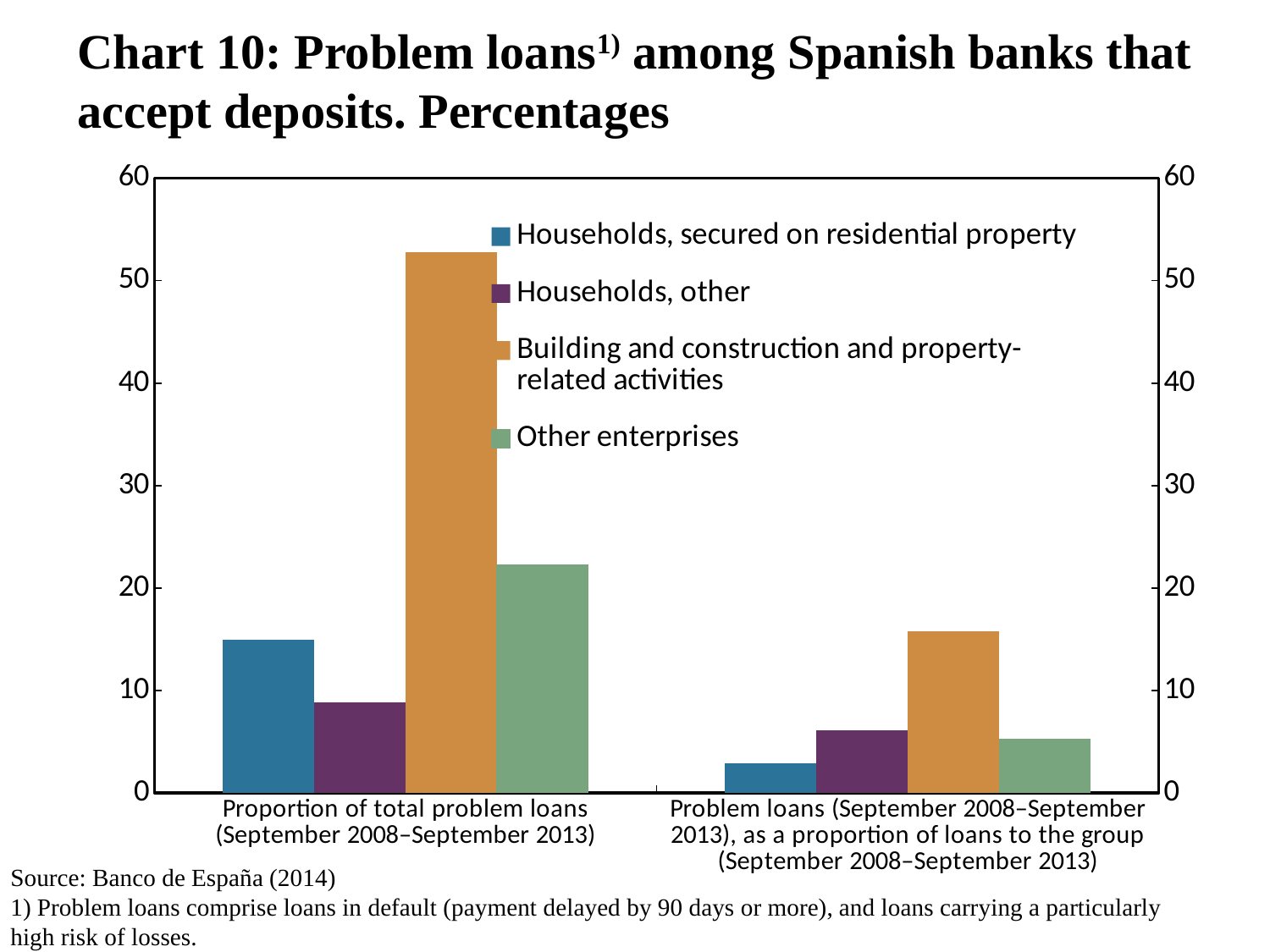
How many series does the legend list? 4 Is the value for 'Building and construction and property-related activities' in 'Proportion of total problem loans (September 2008–September 2013)' greater or less than 50? greater In 'Proportion of total problem loans (September 2008–September 2013)', which is larger: 'Households, secured on residential property' or 'Households, other'? Households, secured on residential property Which series has the lowest value for 'Proportion of total problem loans (September 2008–September 2013)'? Households, other Which series has the lowest value for 'Problem loans (September 2008–September 2013), as a proportion of loans to the group (September 2008–September 2013)'? Households, secured on residential property How many categories are shown on the x axis? 2 Is the value for 'Households, secured on residential property' in 'Proportion of total problem loans (September 2008–September 2013)' greater or less than 10? greater Is the value for 'Building and construction and property-related activities' in 'Problem loans (September 2008–September 2013), as a proportion of loans to the group (September 2008–September 2013)' greater or less than 10? greater Which series has the highest value for 'Proportion of total problem loans (September 2008–September 2013)'? Building and construction and property-related activities What kind of chart is shown on the slide? bar chart What is the source cited below the chart? Banco de España (2014)